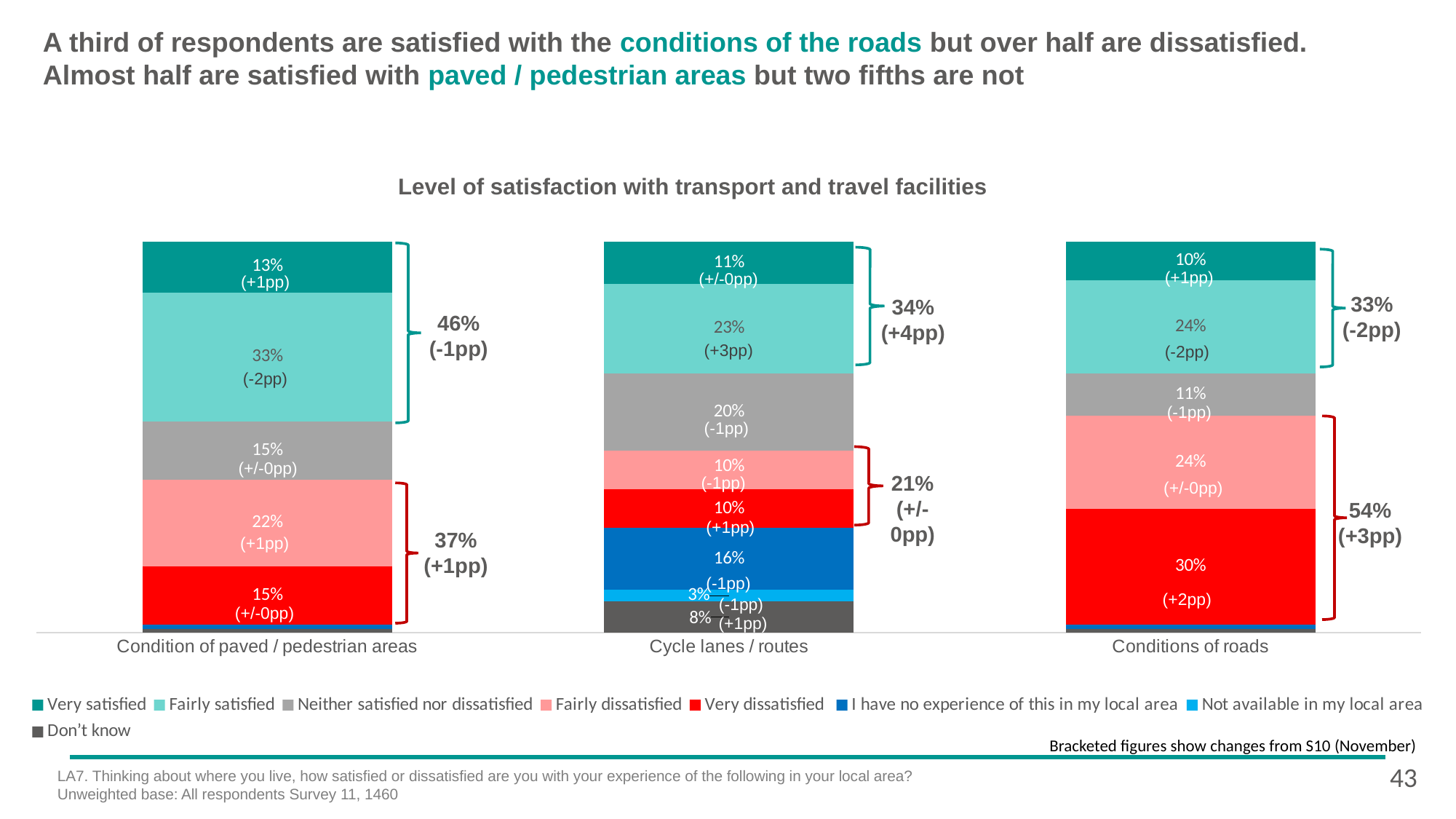
Which has a larger fairly satisfied percentage: condition of paved / pedestrian areas or conditions of roads? Condition of paved / pedestrian areas What percentage of respondents said they have no experience of cycle lanes / routes in their local area? 16% Which category has the highest percentage of very dissatisfied respondents? Conditions of roads How many series does the legend list? 8 What is the bracketed change shown for fairly satisfied with cycle lanes / routes? +3pp What is the combined percentage of very satisfied and fairly satisfied respondents for cycle lanes / routes? 34% How many categories are shown on the x axis of the chart? 3 What percentage of respondents are very dissatisfied with the conditions of roads? 30% What percentage of respondents are fairly satisfied with the condition of paved / pedestrian areas? 33% What type of chart is shown on the slide? Stacked bar chart What is the difference between the very satisfied percentage for condition of paved / pedestrian areas and for conditions of roads? 3% What percentage of respondents are neither satisfied nor dissatisfied with cycle lanes / routes? 20%